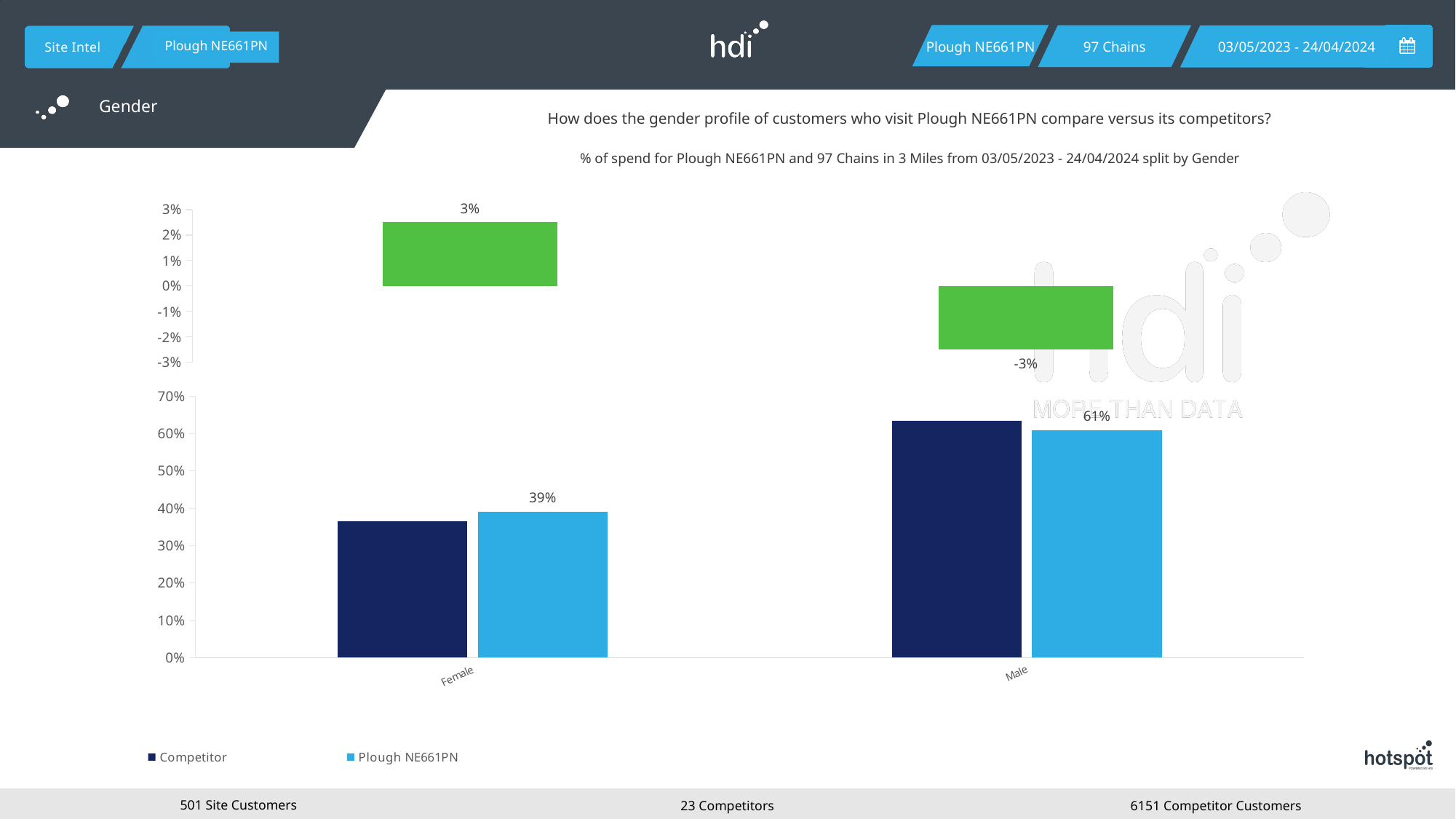
How many series does the legend of the bottom bar chart list? 2 In the bottom bar chart, which is larger in the Female category, the Competitor bar or the Plough NE661PN bar? Plough NE661PN In the bottom bar chart, what is the value for Plough NE661PN in the Male category? 61% In the bottom bar chart, which category has the higher value for Plough NE661PN, Female or Male? Male In the top chart with green bars, what is the value shown for Female? 3% In the top chart with green bars, what is the value shown for Male? -3% In the bottom bar chart, what is the difference between the Plough NE661PN values for Male and Female? 22% In the bottom bar chart, is the Competitor value for Male greater or less than 60%? greater What kind of chart is the bottom chart on the slide? Bar chart In the bottom bar chart, is the Competitor value for Female greater or less than 40%? less How many categories are shown on the x axis of the bottom bar chart? 2 In the bottom bar chart, what is the value for Plough NE661PN in the Female category? 39%